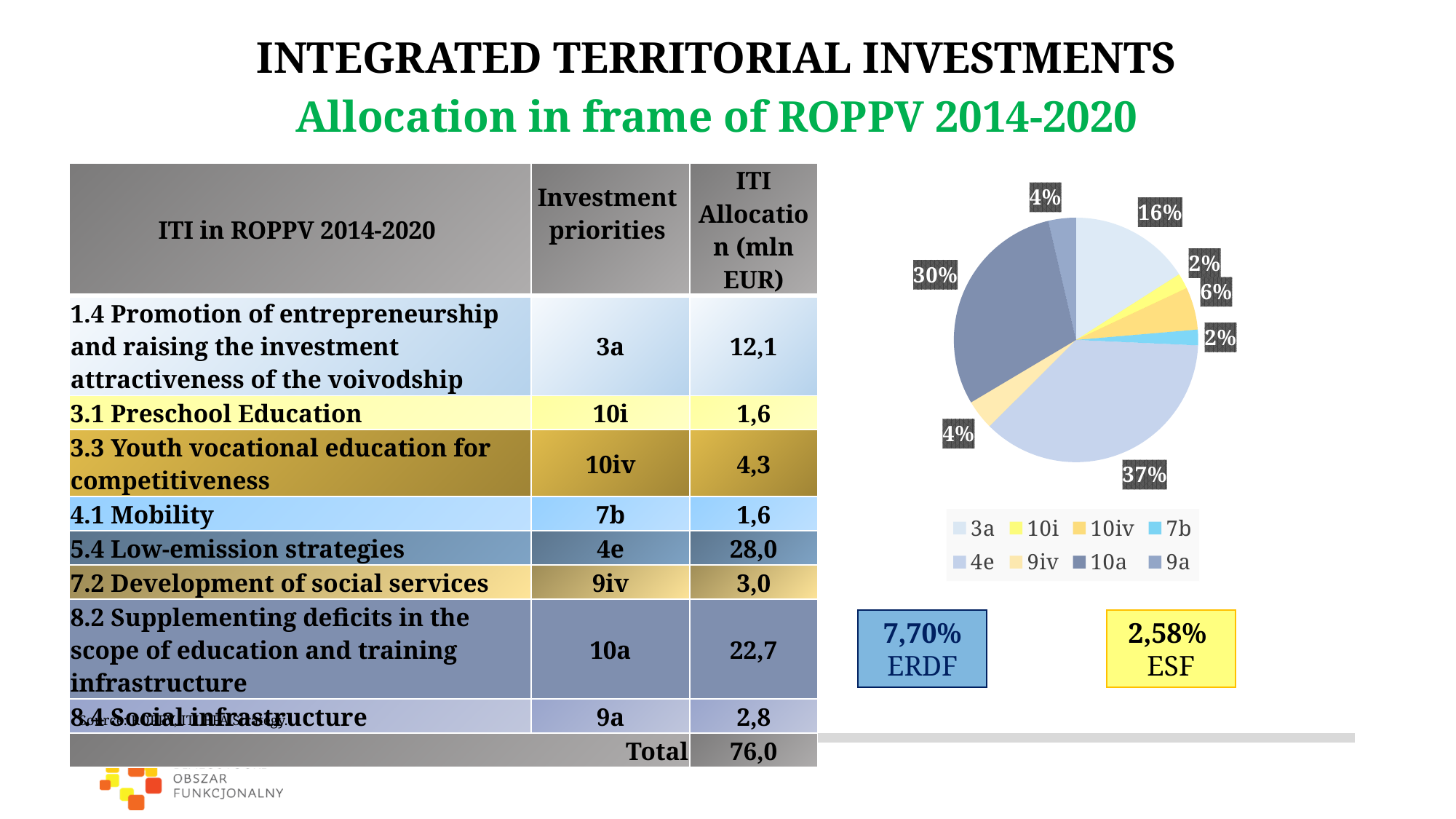
What colour is the 10i slice in the pie chart? yellow What share of the pie chart does 4e represent? 37% What share of the pie chart does 10a represent? 30% What share of the pie chart does 3a represent? 16% Which is larger in the pie chart, 3a or 10a? 10a Which category has the largest slice in the pie chart? 4e How many entries does the pie chart legend list? 8 What is the difference in percentage points between the 4e slice and the 10a slice? 7% How many slices does the pie chart have? 8 What is the difference in percentage points between the 3a slice and the 10iv slice? 10% What type of chart is shown on the slide? pie chart